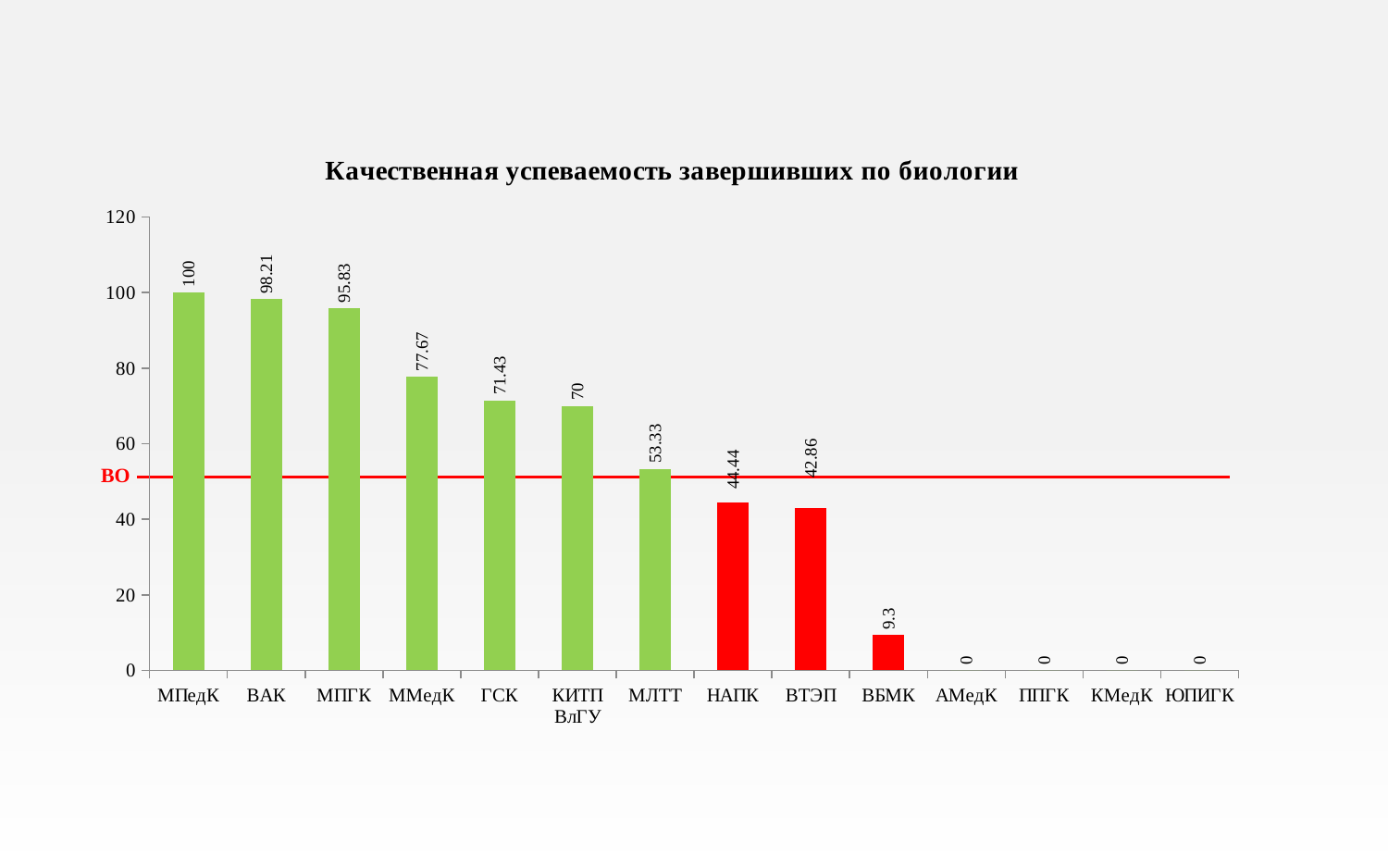
Is the value for МЛТТ greater or less than 60? less What is the label on the red horizontal line? ВО What is the value for ММедК? 77.67 Which category has the lowest non-zero value? ВБМК Which category has the highest value? МПедК What is the difference between the values for МПедК and МПГК? 4.17 Do the values rise or fall from left to right along the x axis? fall What is the value for ВБМК? 9.3 How many categories are shown on the x axis? 14 What is the value for ВАК? 98.21 What kind of chart is shown on the slide? bar chart Which is larger, the value for ГСК or the value for КИТП ВлГУ? ГСК